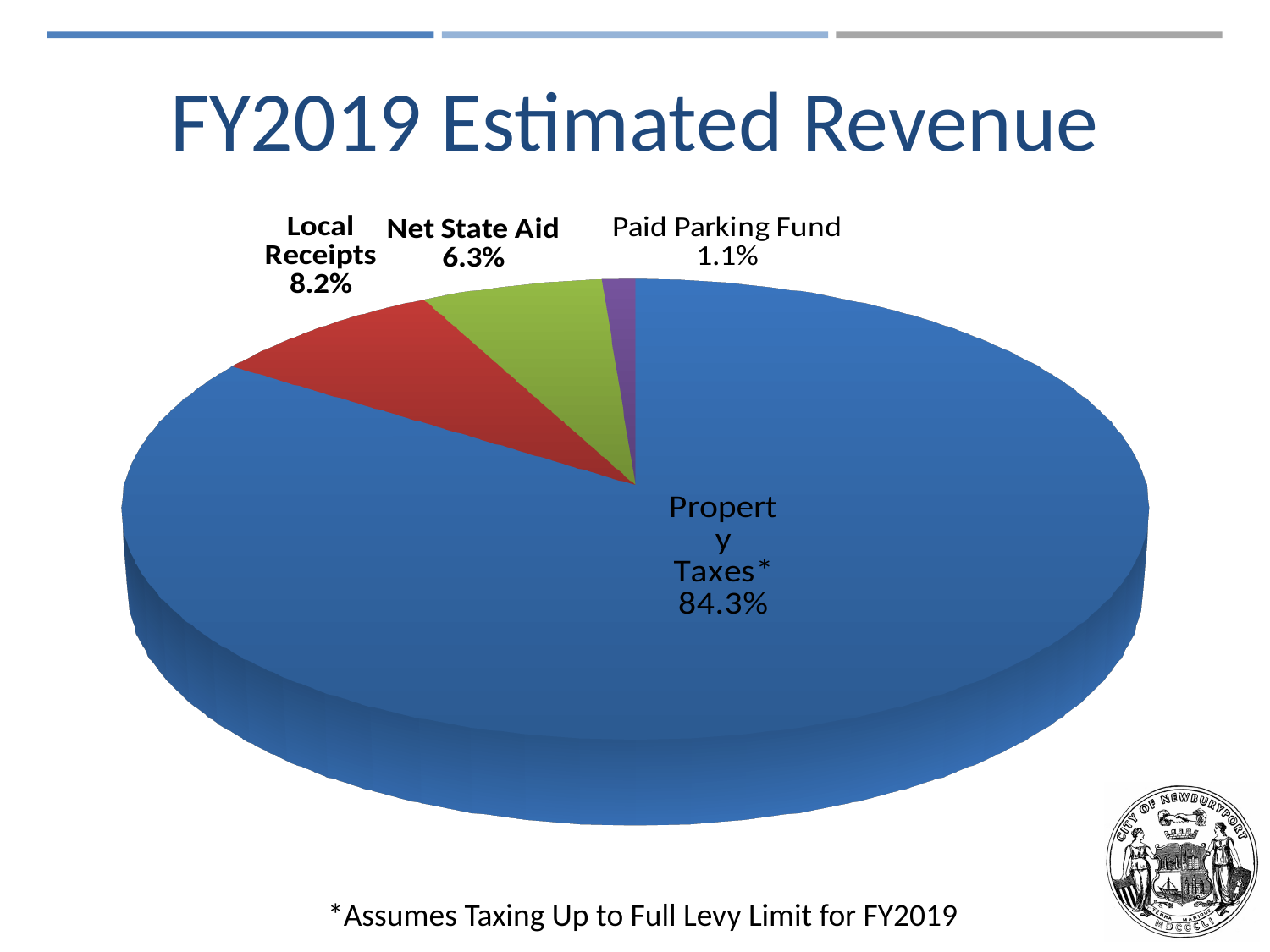
What share of FY2019 estimated revenue comes from the Paid Parking Fund? 1.1% What share of FY2019 estimated revenue comes from Local Receipts? 8.2% Which is larger, the share for Net State Aid or the share for the Paid Parking Fund? Net State Aid What share of FY2019 estimated revenue comes from Net State Aid? 6.3% Which revenue source has the largest share of the pie? Property Taxes* What share of FY2019 estimated revenue comes from Property Taxes*? 84.3% What is the title of the chart? FY2019 Estimated Revenue What kind of chart is shown on the slide? Pie chart How many slices does the pie chart have? 4 What colour is the Property Taxes* slice? Blue What is the difference in percentage points between Local Receipts and Net State Aid? 1.9 Which revenue source has the smallest share of the pie? Paid Parking Fund